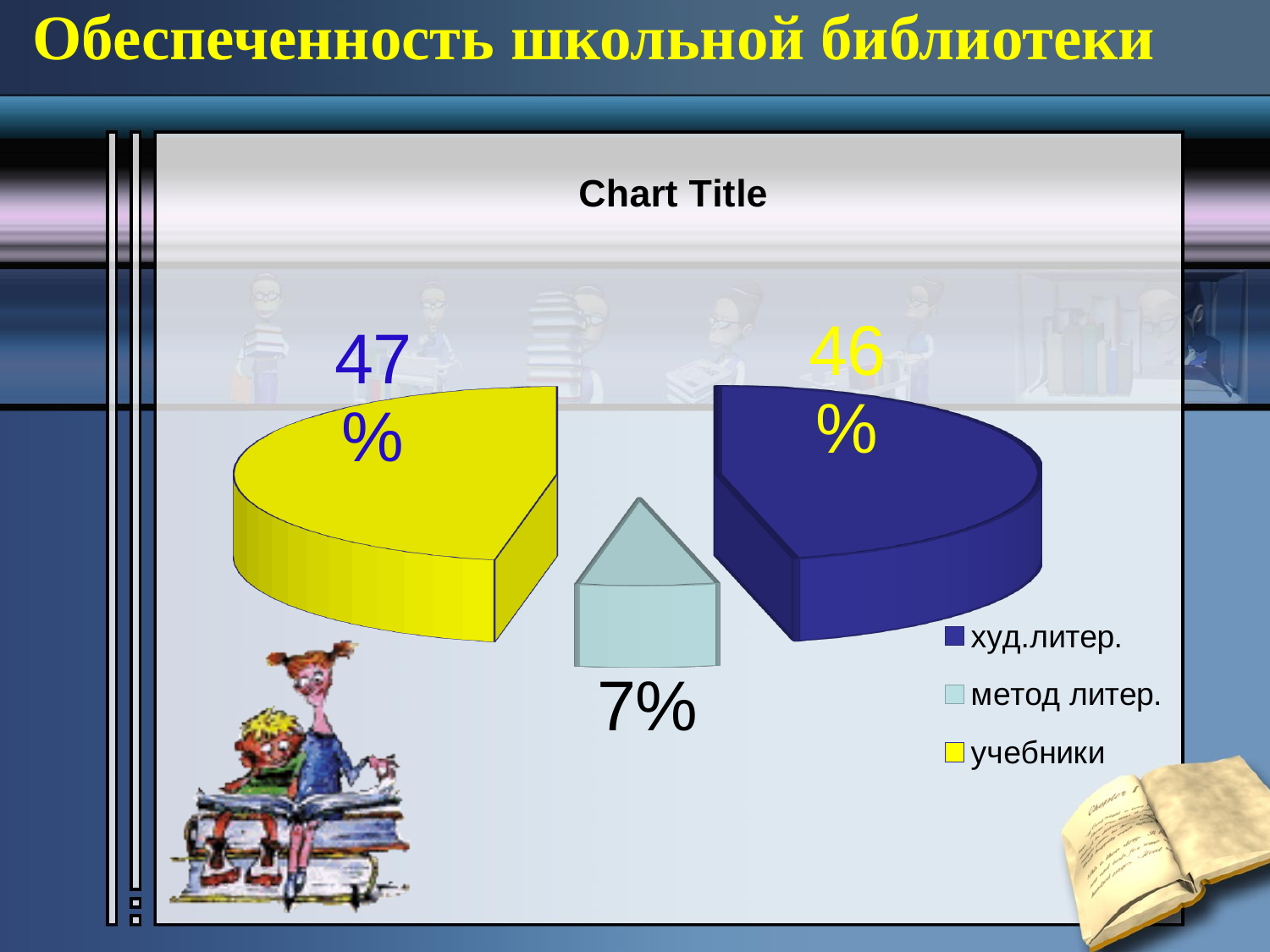
Which category has the smallest share of the pie? метод литер. What kind of chart is shown on the slide? pie chart What is the value for учебники? 47% How many entries does the legend list? 3 Which is larger, the value for худ.литер. or the value for метод литер.? худ.литер. What colour is the slice for учебники? yellow Which category has the largest share of the pie? учебники What is the value for худ.литер.? 46% How many slices does the pie chart have? 3 What is the difference between the values for учебники and метод литер.? 40% What is the value for метод литер.? 7% What is the difference between the values for худ.литер. and метод литер.? 39%